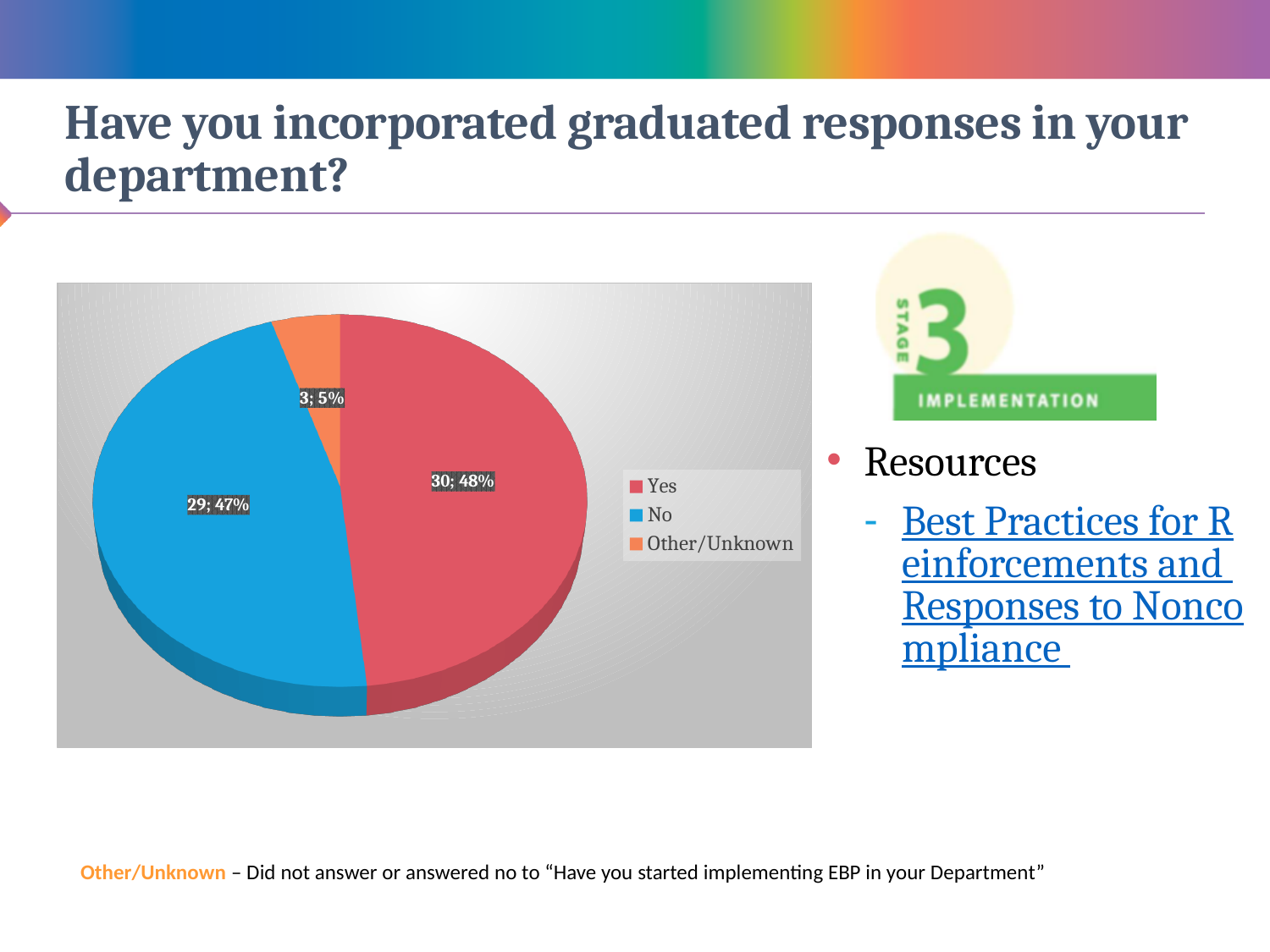
What is the count for the Other/Unknown slice? 3 What is the difference between the Yes count and the Other/Unknown count? 27 Which category has the smallest slice? Other/Unknown Which colour represents the No category in the pie chart? Blue How many entries does the legend list? 3 How many slices does the pie chart have? 3 What share of the pie does the No slice represent? 47% What share of the pie does the Yes slice represent? 48% What share of the pie does the Other/Unknown slice represent? 5% What is the count for the No slice? 29 What kind of chart is shown on the slide? Pie chart What is the count for the Yes slice? 30